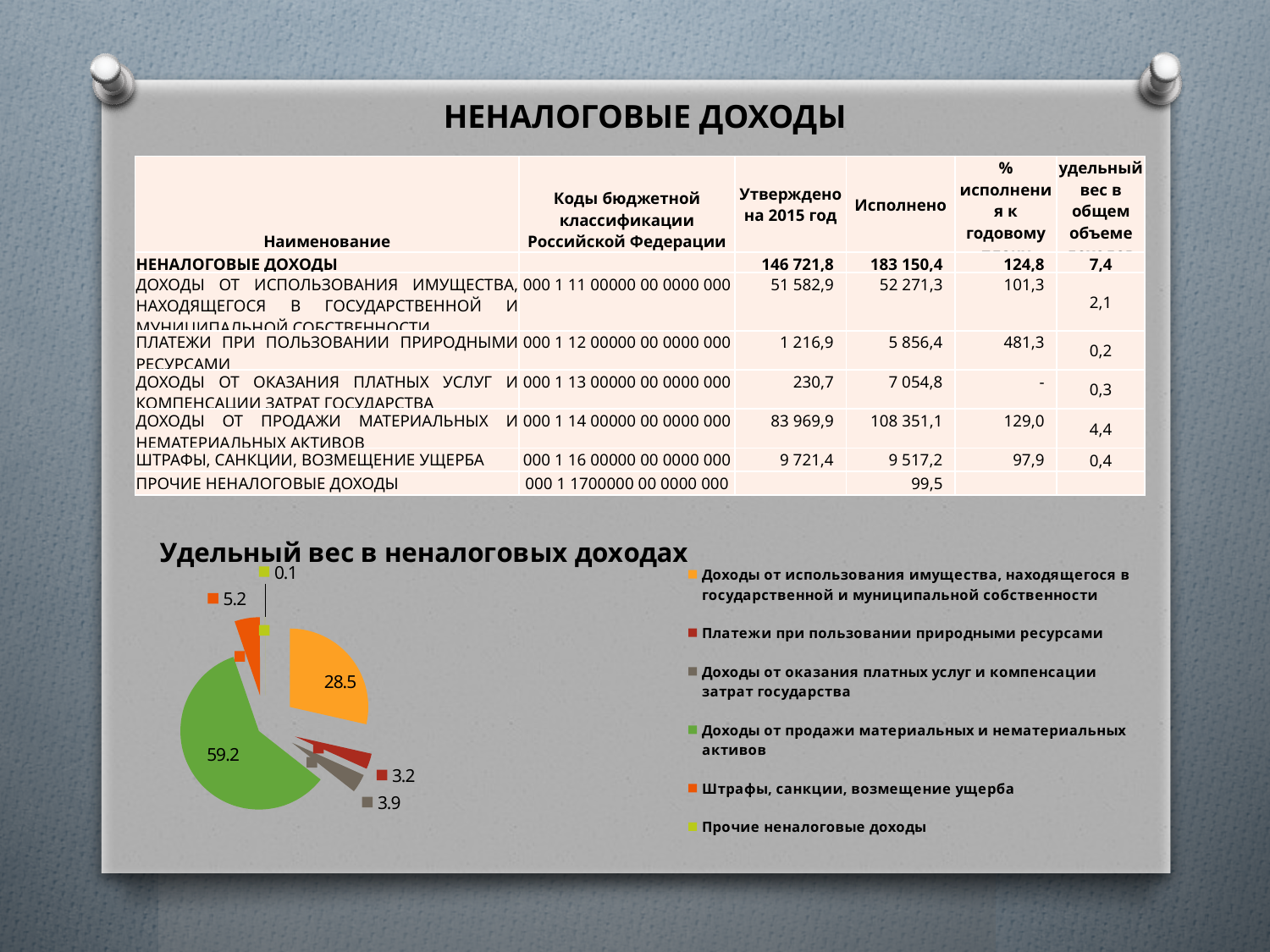
What is the value for 'Доходы от использования имущества, находящегося в государственной и муниципальной собственности' in the pie chart? 28.5 What is the difference between the values for 'Доходы от продажи материальных и нематериальных активов' and 'Доходы от использования имущества, находящегося в государственной и муниципальной собственности'? 30.7 What is the title of the chart on the slide? Удельный вес в неналоговых доходах How many slices does the pie chart have? 6 How many entries does the chart legend list? 6 Which category has the smallest slice in the pie chart? Прочие неналоговые доходы What kind of chart is shown on the slide? pie chart What is the value for 'Прочие неналоговые доходы' in the pie chart? 0.1 Which is larger in the pie chart: 'Платежи при пользовании природными ресурсами' or 'Штрафы, санкции, возмещение ущерба'? Штрафы, санкции, возмещение ущерба What is the value for 'Доходы от продажи материальных и нематериальных активов' in the pie chart? 59.2 What is the value for 'Штрафы, санкции, возмещение ущерба' in the pie chart? 5.2 Which category has the largest slice in the pie chart? Доходы от продажи материальных и нематериальных активов